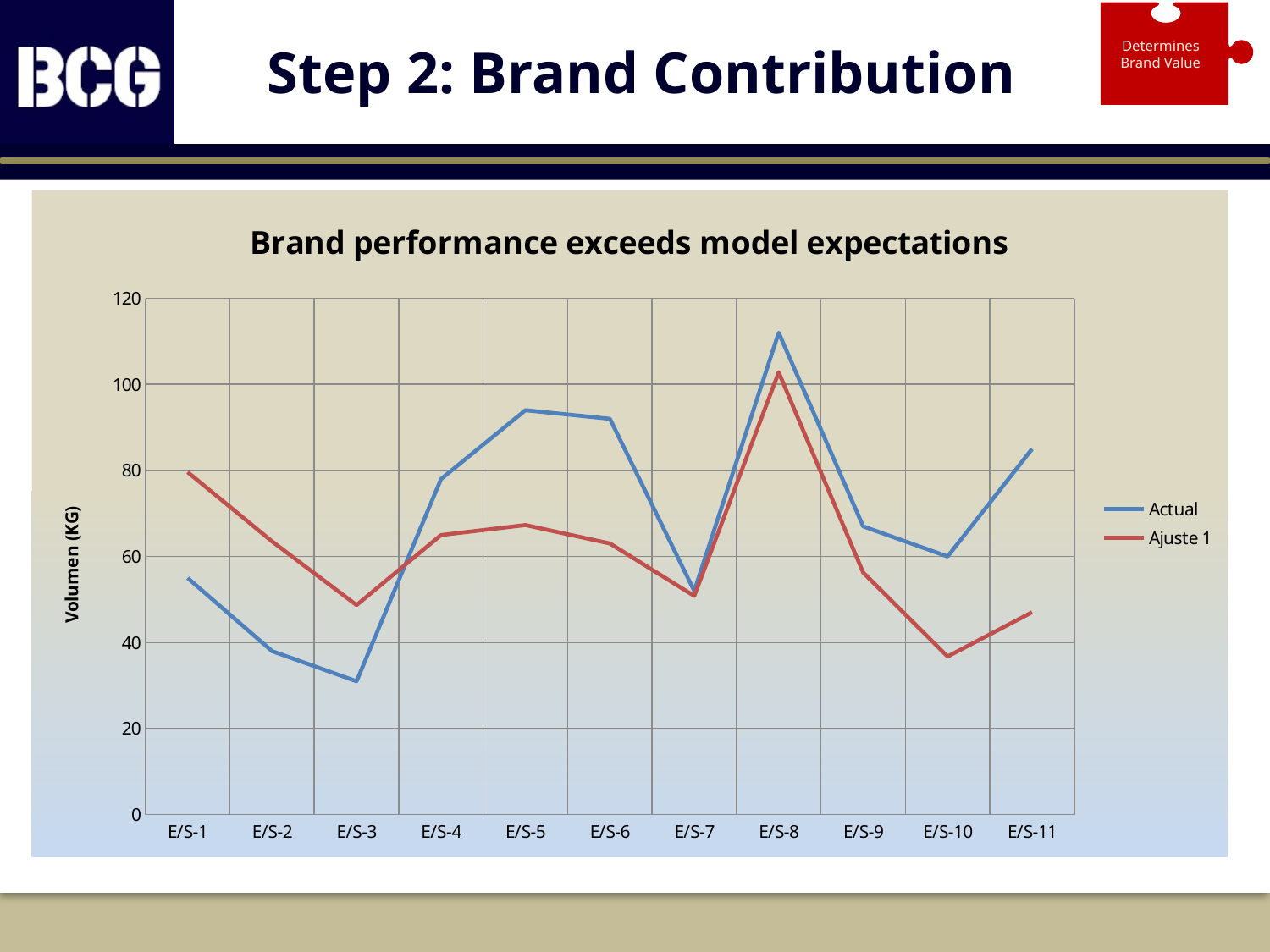
Is the Actual value at E/S-3 greater or less than 40? less At which category does the Actual series reach its highest value? E/S-8 At which category does the Ajuste 1 series reach its highest value? E/S-8 How many series does the legend list? 2 What type of chart is shown on the slide? Line chart Does the Actual series rise or fall from E/S-1 to E/S-3? Fall How many categories are shown on the x axis? 11 At E/S-1, which series has the higher value, Actual or Ajuste 1? Ajuste 1 At which category does the Ajuste 1 series reach its lowest value? E/S-10 Is the Actual value at E/S-8 greater or less than 100? greater Is the Ajuste 1 value at E/S-3 greater or less than 60? less At which category does the Actual series reach its lowest value? E/S-3